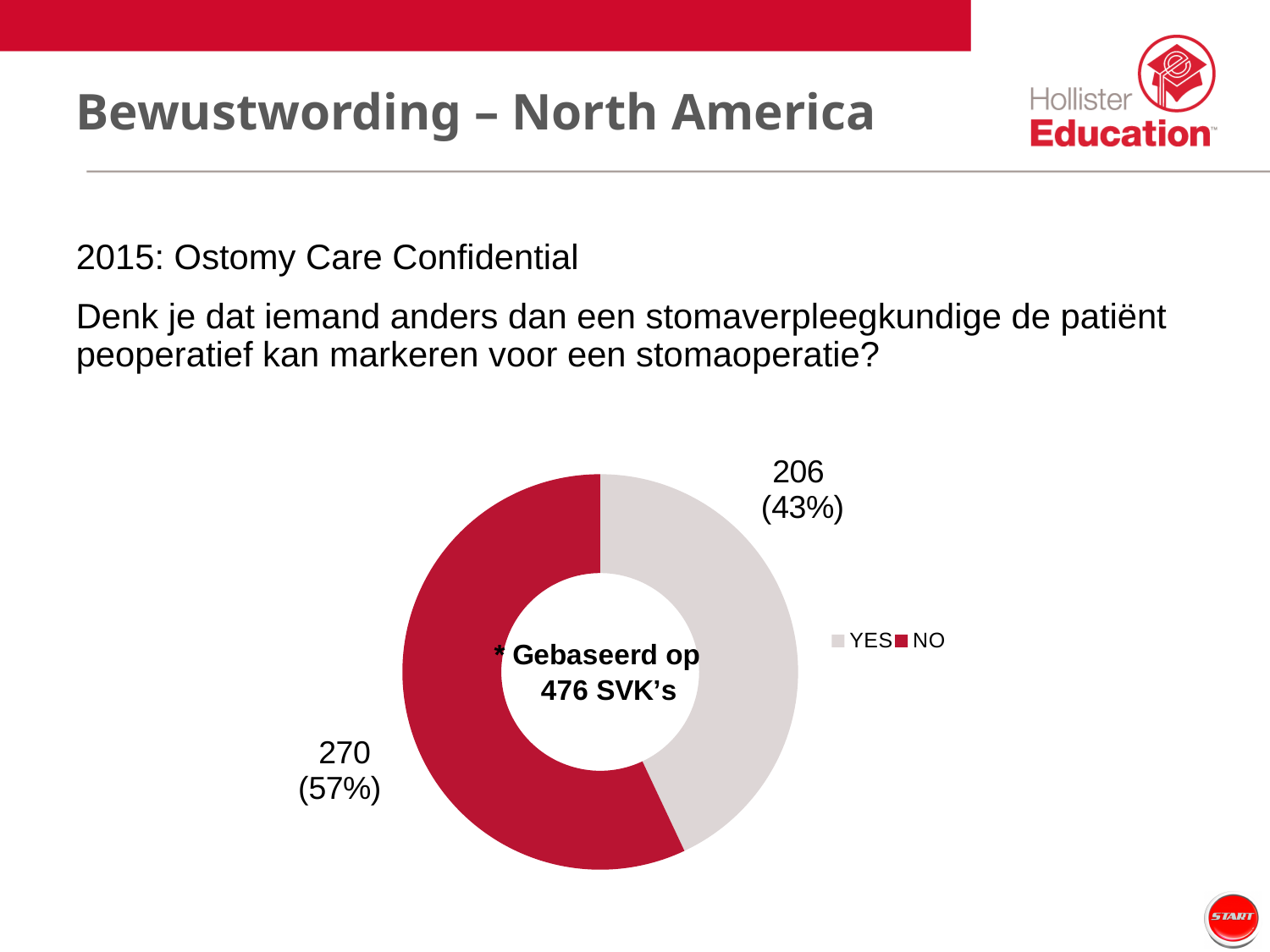
What kind of chart is shown on the slide? Doughnut (pie) chart What percentage of respondents answered NO? 57% How many categories does the chart show? 2 How many respondents answered NO? 270 Which colour represents the NO responses in the chart? Red What is the total number of responses shown in the chart? 476 Which response has the larger share, YES or NO? NO How many entries does the legend list? 2 Which response category has the smallest slice? YES What is the difference between the number of NO and YES responses? 64 How many respondents answered YES? 206 What percentage of respondents answered YES? 43%